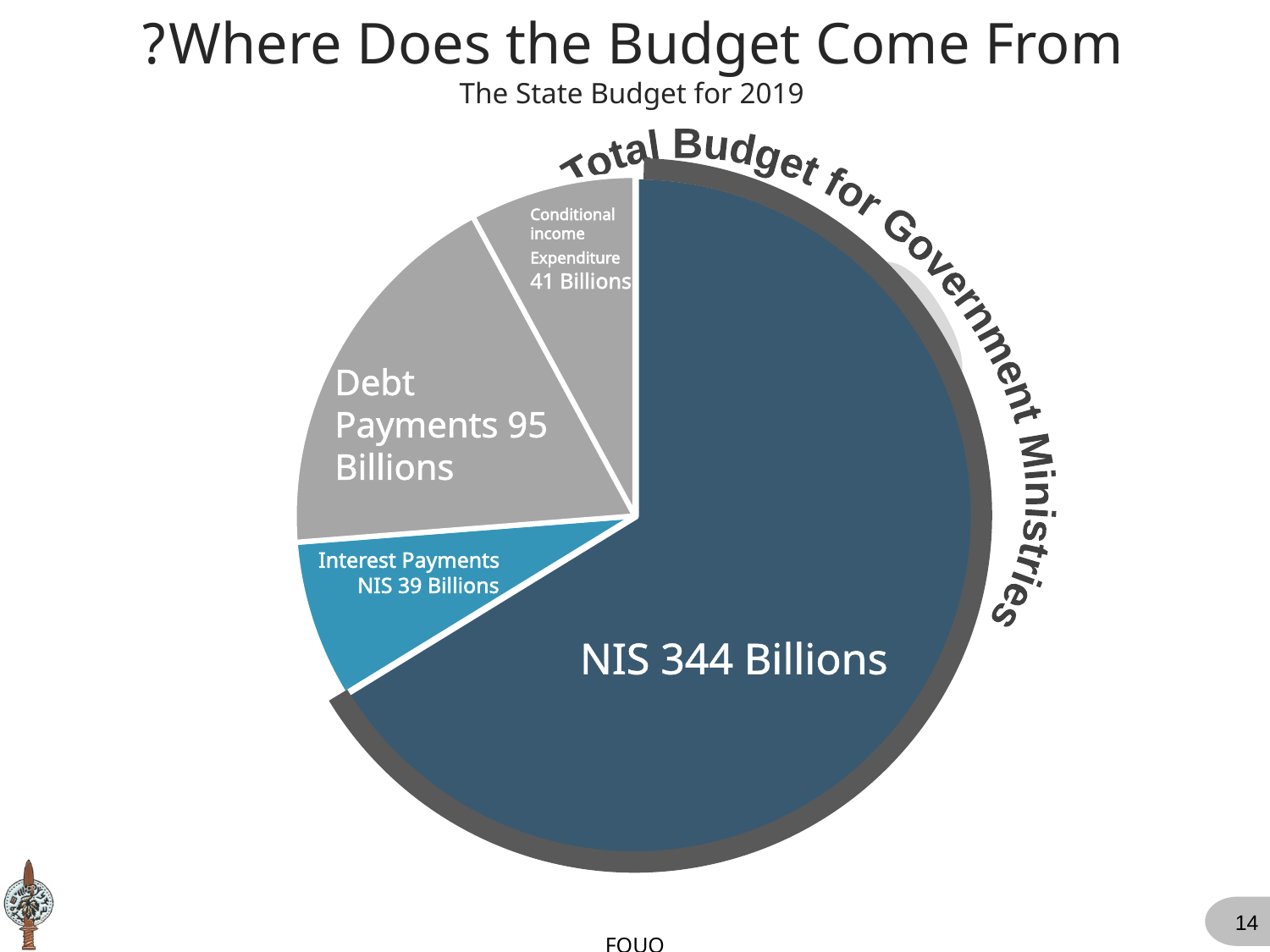
Which is larger, Debt Payments or Interest Payments? Debt Payments What is the subtitle shown above the pie chart? The State Budget for 2019 Which slice of the pie chart is the largest? Total Budget for Government Ministries What is the value shown for Debt Payments? 95 Billions What is the value shown for Interest Payments? NIS 39 Billions What is the value shown for Conditional income Expenditure? 41 Billions What is the difference in billions between Total Budget for Government Ministries and Debt Payments? 249 What is the difference in billions between Debt Payments and Conditional income Expenditure? 54 What is the value shown for Total Budget for Government Ministries? NIS 344 Billions How many slices does the pie chart have? 4 What type of chart is shown on the slide? pie chart Which slice of the pie chart is the smallest? Interest Payments